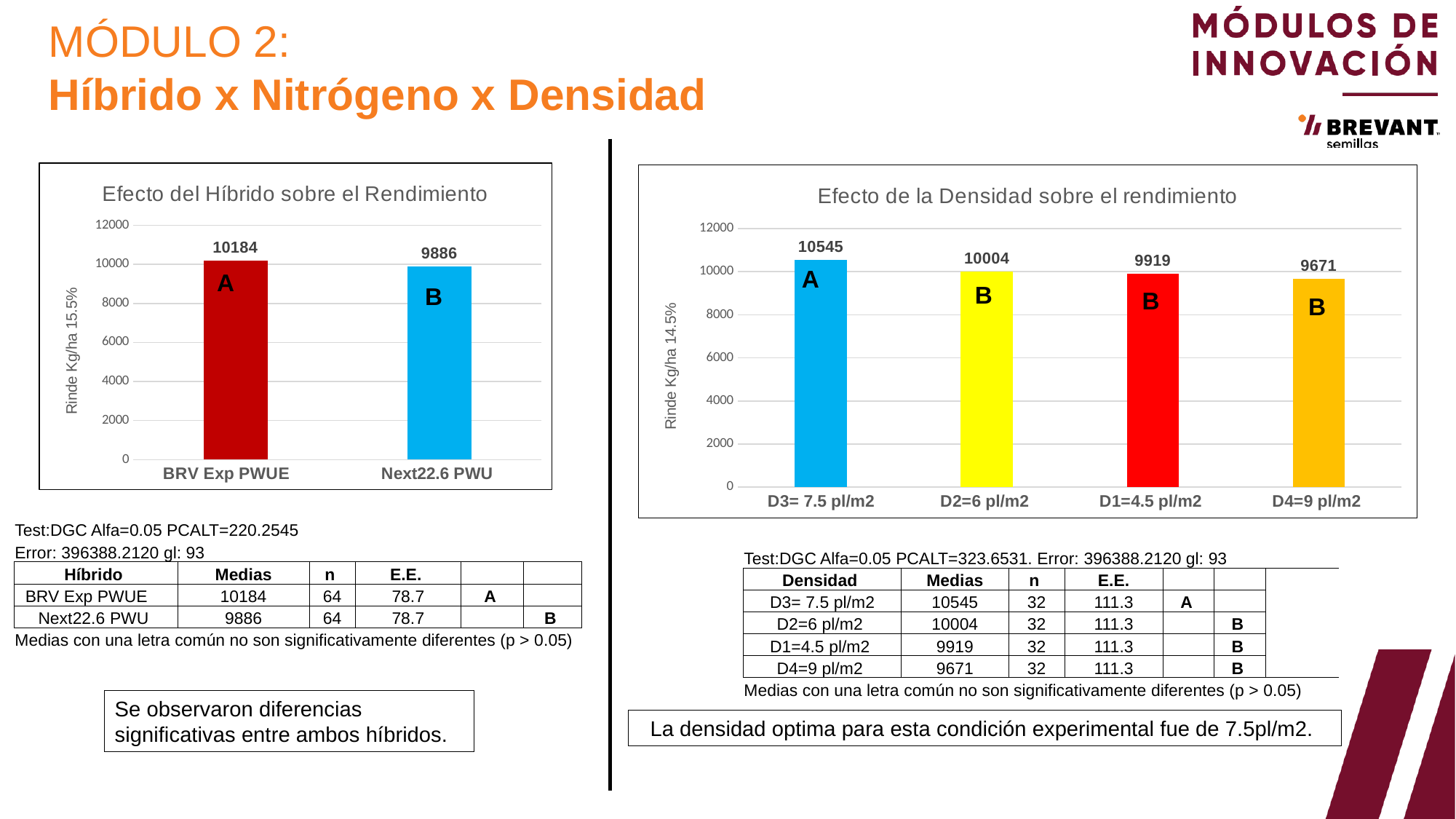
What kind of chart is 'Efecto de la Densidad sobre el rendimiento'? bar chart In the chart 'Efecto de la Densidad sobre el rendimiento', which category has the lowest value? D4=9 pl/m2 In the chart 'Efecto de la Densidad sobre el rendimiento', which category has the highest value? D3= 7.5 pl/m2 In the chart 'Efecto de la Densidad sobre el rendimiento', what is the value for D3= 7.5 pl/m2? 10545 In the chart 'Efecto del Híbrido sobre el Rendimiento', what is the difference between the values for BRV Exp PWUE and Next22.6 PWU? 298 In the chart 'Efecto del Híbrido sobre el Rendimiento', what is the value for Next22.6 PWU? 9886 In the chart 'Efecto de la Densidad sobre el rendimiento', how many categories are plotted? 4 In the chart 'Efecto de la Densidad sobre el rendimiento', what is the difference between the values for D3= 7.5 pl/m2 and D2=6 pl/m2? 541 In the chart 'Efecto del Híbrido sobre el Rendimiento', how many categories are plotted? 2 In the chart 'Efecto de la Densidad sobre el rendimiento', do the values rise or fall from left to right along the x axis? fall In the chart 'Efecto de la Densidad sobre el rendimiento', what is the value for D4=9 pl/m2? 9671 In the chart 'Efecto del Híbrido sobre el Rendimiento', what is the value for BRV Exp PWUE? 10184